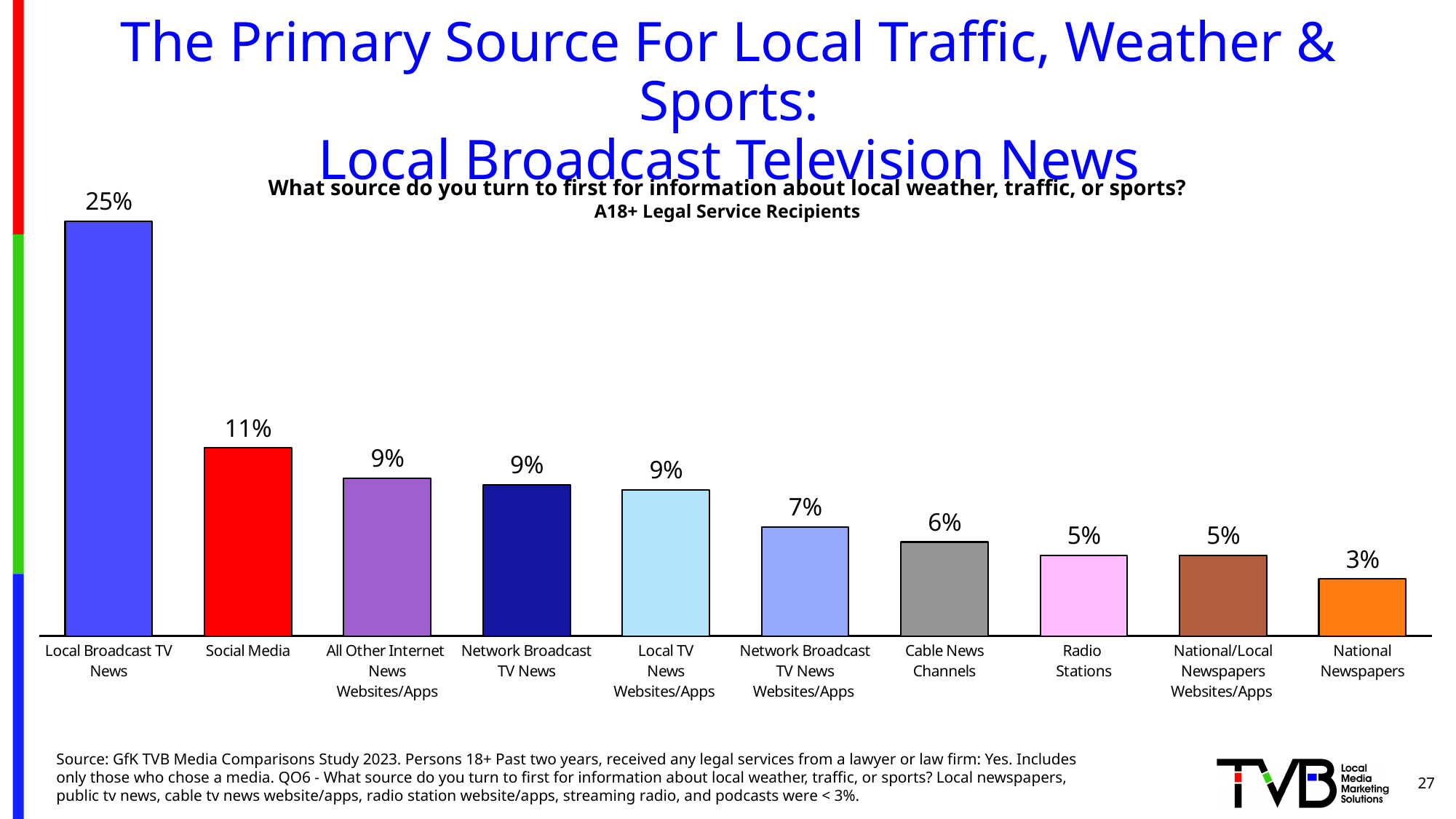
What is the value shown for Social Media? 11% What is the difference in percentage points between Local Broadcast TV News and Social Media? 14 Which source has the highest percentage on the chart? Local Broadcast TV News What is the value shown for Cable News Channels? 6% What colour is the bar for Social Media? Red What kind of chart is shown on the slide? Bar chart What percentage of A18+ legal service recipients turn first to Local Broadcast TV News for local weather, traffic, or sports? 25% Do the values generally rise or fall moving from left to right across the chart? Fall Which is larger, the value for Network Broadcast TV News Websites/Apps or the value for Radio Stations? Network Broadcast TV News Websites/Apps Which source has the lowest percentage on the chart? National Newspapers What is the value shown for National Newspapers? 3% How many sources (bars) are shown on the chart? 10